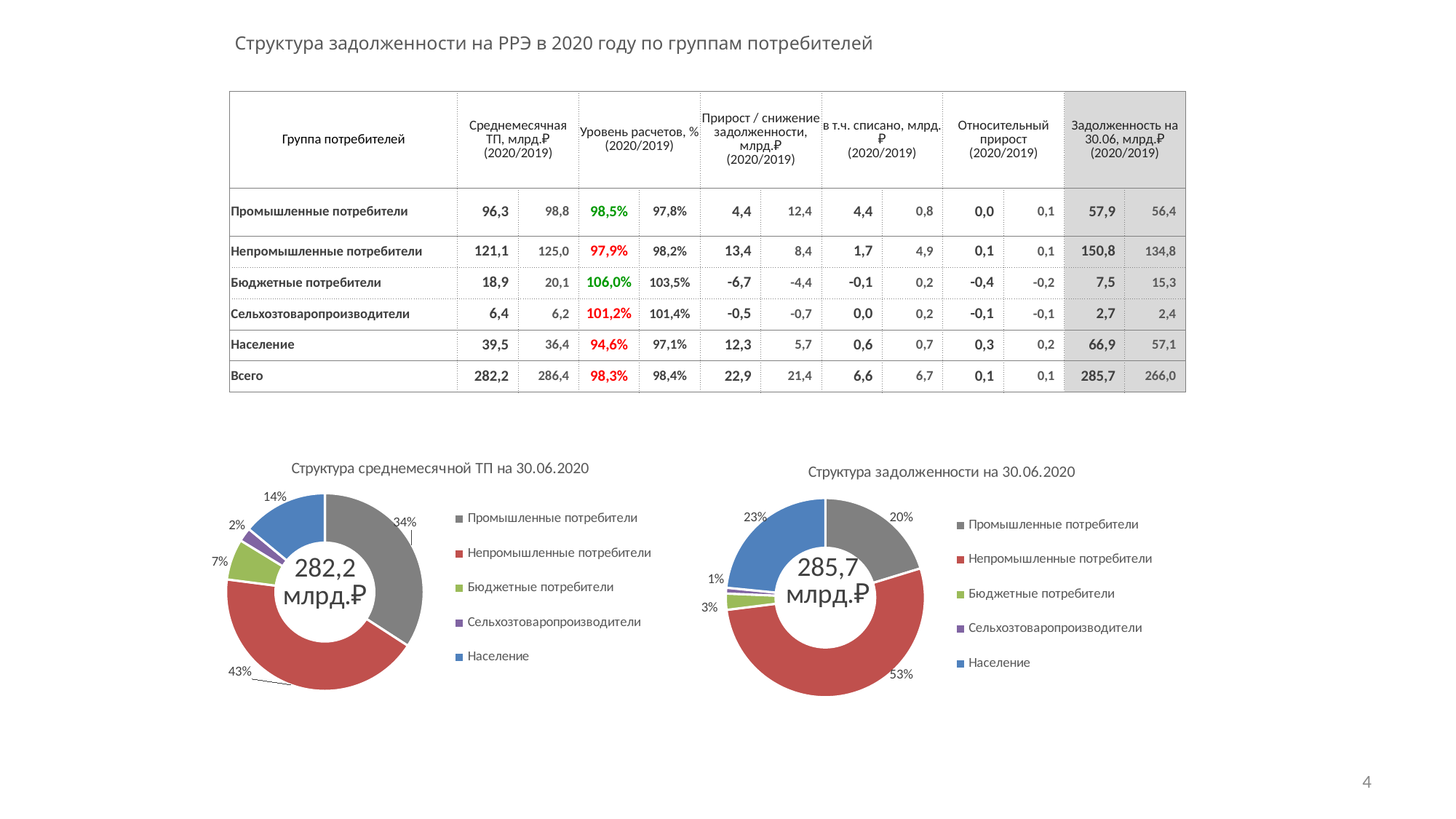
What total value is shown in the centre of the chart titled "Структура задолженности на 30.06.2020"? 285,7 млрд.₽ In the chart titled "Структура задолженности на 30.06.2020", what is the difference in percentage points between the shares of "Непромышленные потребители" and "Население"? 30 In the chart titled "Структура среднемесячной ТП на 30.06.2020", what share does "Непромышленные потребители" have? 43% In the chart titled "Структура задолженности на 30.06.2020", what share does "Бюджетные потребители" have? 3% How many categories does the legend of the chart titled "Структура задолженности на 30.06.2020" list? 5 In the chart titled "Структура задолженности на 30.06.2020", what share does "Промышленные потребители" have? 20% In the chart titled "Структура задолженности на 30.06.2020", which category has the smallest share? Сельхозтоваропроизводители In the chart titled "Структура среднемесячной ТП на 30.06.2020", what colour represents "Бюджетные потребители"? Green What type of chart is the one titled "Структура среднемесячной ТП на 30.06.2020"? Donut (pie) chart In the chart titled "Структура среднемесячной ТП на 30.06.2020", what share does "Население" have? 14% In the chart titled "Структура среднемесячной ТП на 30.06.2020", which has the larger share: "Промышленные потребители" or "Население"? Промышленные потребители In the chart titled "Структура среднемесячной ТП на 30.06.2020", which category has the largest share? Непромышленные потребители